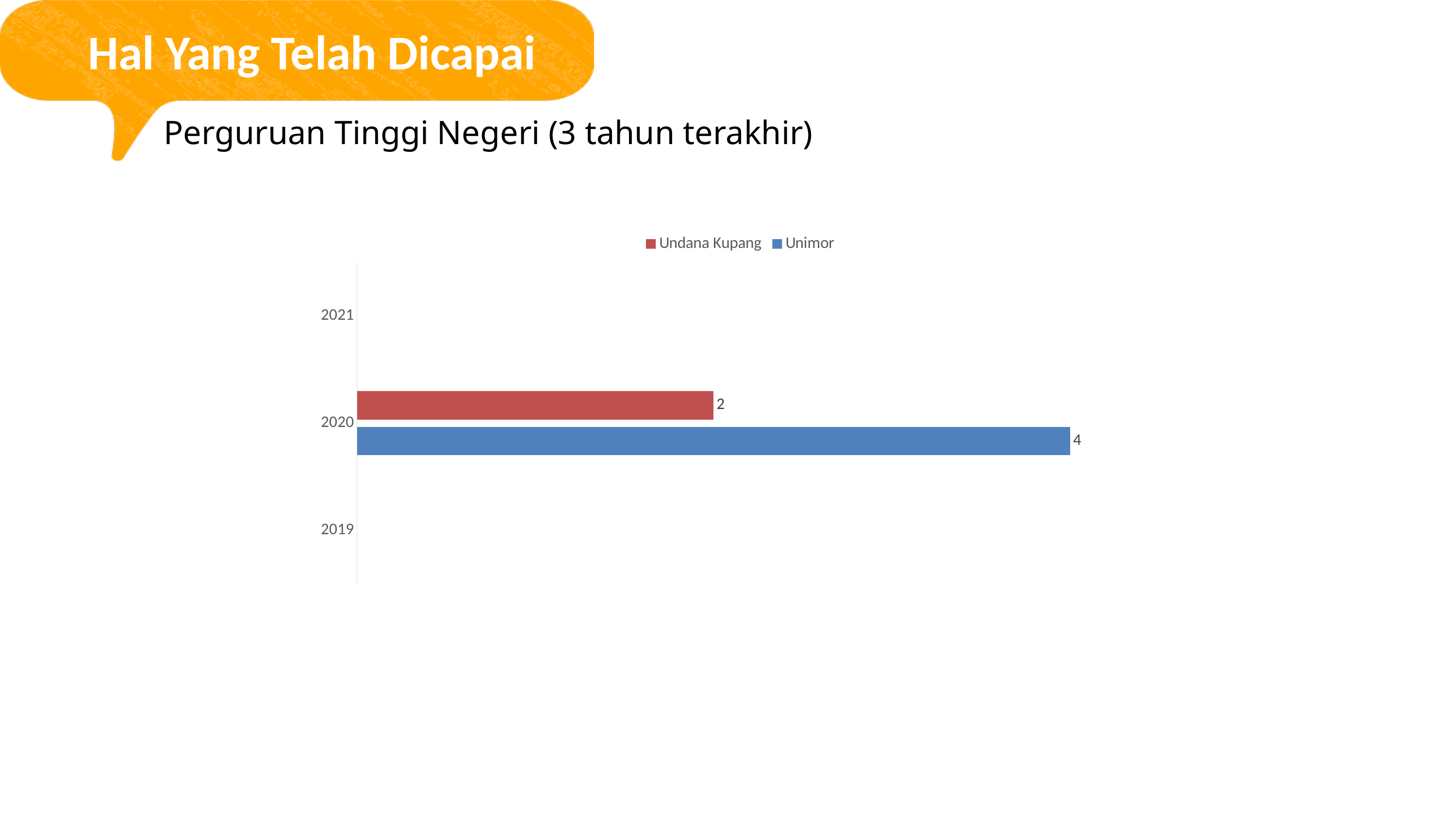
Which series has the larger value in 2020, Undana Kupang or Unimor? Unimor What kind of chart is shown on the slide? bar chart What is the value for Undana Kupang in 2020? 2 What colour is the bar for Unimor? blue What is the total of the two bars for 2020? 6 How many year categories are shown on the vertical axis? 3 How many series does the legend list? 2 What is the difference between the Unimor and Undana Kupang values in 2020? 2 Which year is the only one with bars plotted? 2020 What is the value for Unimor in 2020? 4